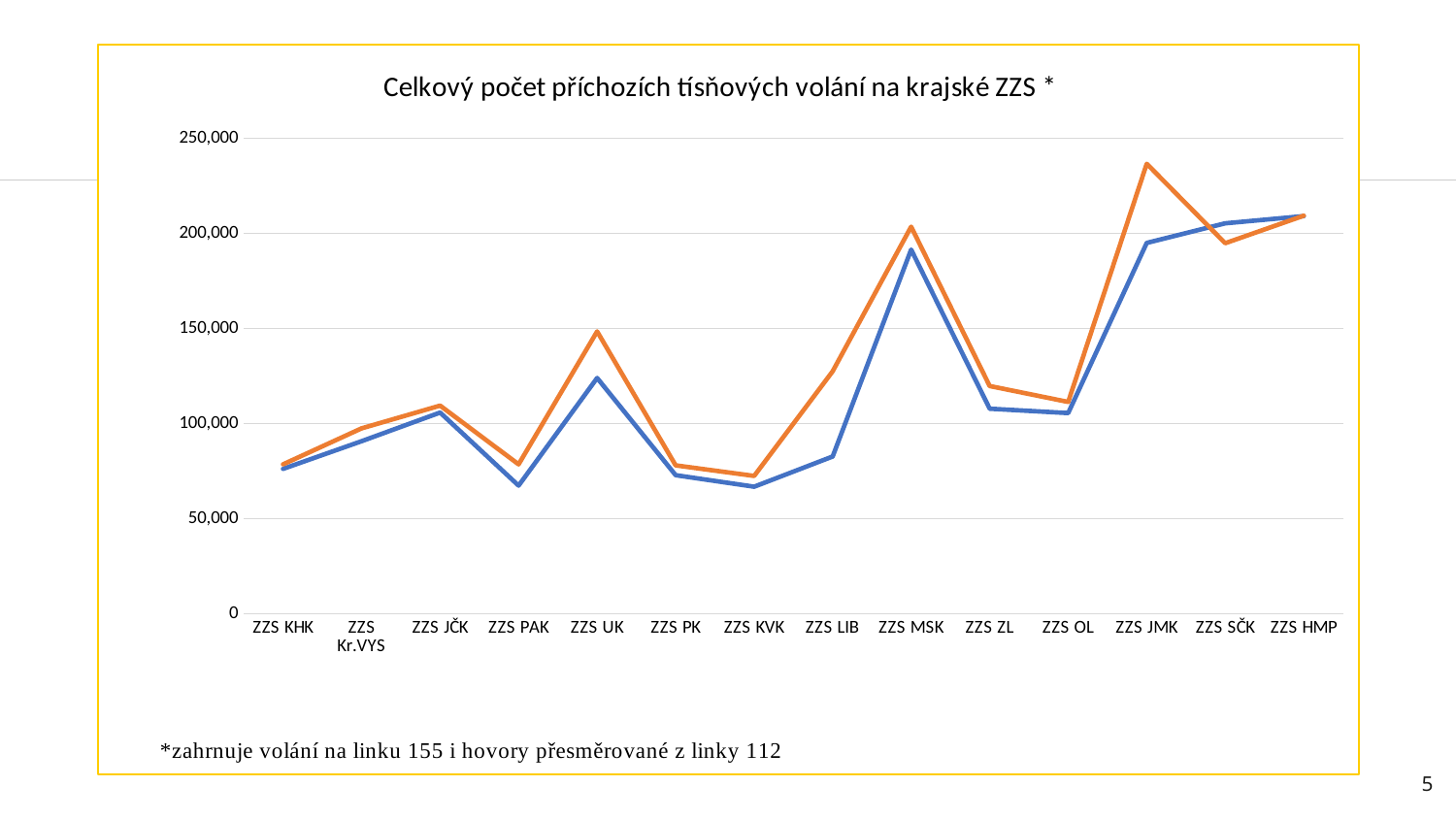
What type of chart is shown on the slide? Line chart How many lines are plotted on the chart? 2 Do the values rise or fall from ZZS MSK to ZZS ZL? Fall At ZZS JMK, which line has the higher value, the orange line or the blue line? Orange line What is the title of the chart? Celkový počet příchozích tísňových volání na krajské ZZS * Is the value of the blue line for ZZS PAK greater or less than 100,000? less On the orange line, which is larger: the value for ZZS JMK or the value for ZZS SČK? ZZS JMK Is the value of the orange line for ZZS JMK greater or less than 200,000? greater How many categories (ZZS regions) are shown on the x axis? 14 Is the value of the orange line for ZZS KVK greater or less than 100,000? less For which category does the orange line reach its highest value? ZZS JMK